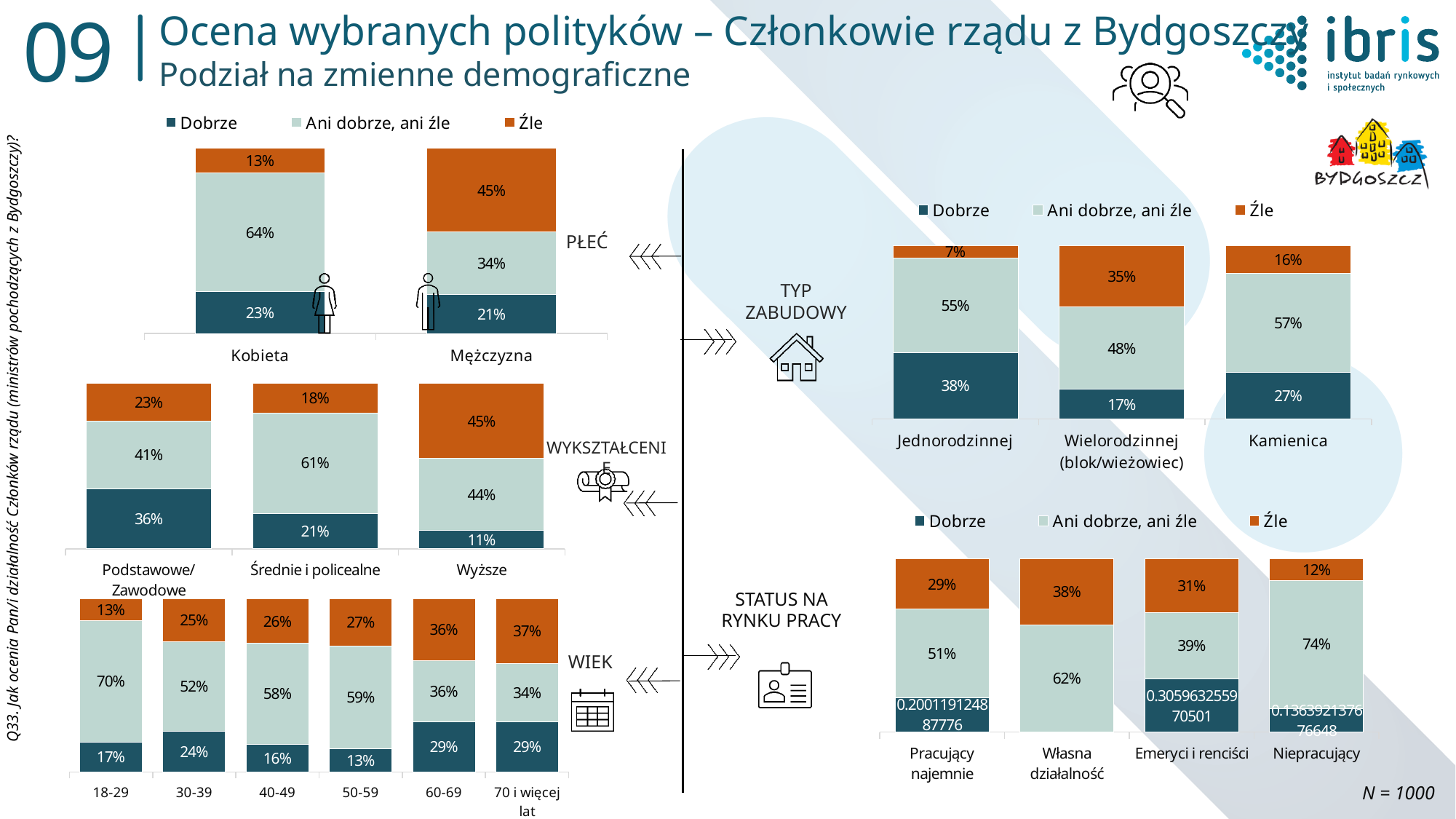
In the STATUS NA RYNKU PRACY chart, what is the "Ani dobrze, ani źle" value for Niepracujący? 74% In the TYP ZABUDOWY chart, which housing type has the lowest "Źle" value? Jednorodzinnej In the WYKSZTAŁCENIE chart, what is the "Dobrze" value for Wyższe? 11% In the WIEK chart, what is the "Ani dobrze, ani źle" value for the 18-29 group? 70% In the WIEK chart, which age group has the lowest "Dobrze" value? 50-59 How many series does the legend of the TYP ZABUDOWY chart list? 3 In the PŁEĆ chart, what is the difference between the "Źle" values for Mężczyzna and Kobieta? 32 percentage points In the TYP ZABUDOWY chart, is the "Dobrze" value larger for Jednorodzinnej or for Kamienica? Jednorodzinnej In the WIEK chart, how many age groups are shown? 6 In the PŁEĆ chart, what percentage of Kobieta respondents answered "Ani dobrze, ani źle"? 64% In the WYKSZTAŁCENIE chart, which education group has the highest "Dobrze" value? Podstawowe/Zawodowe In the PŁEĆ chart, what is the "Źle" value for Mężczyzna? 45%